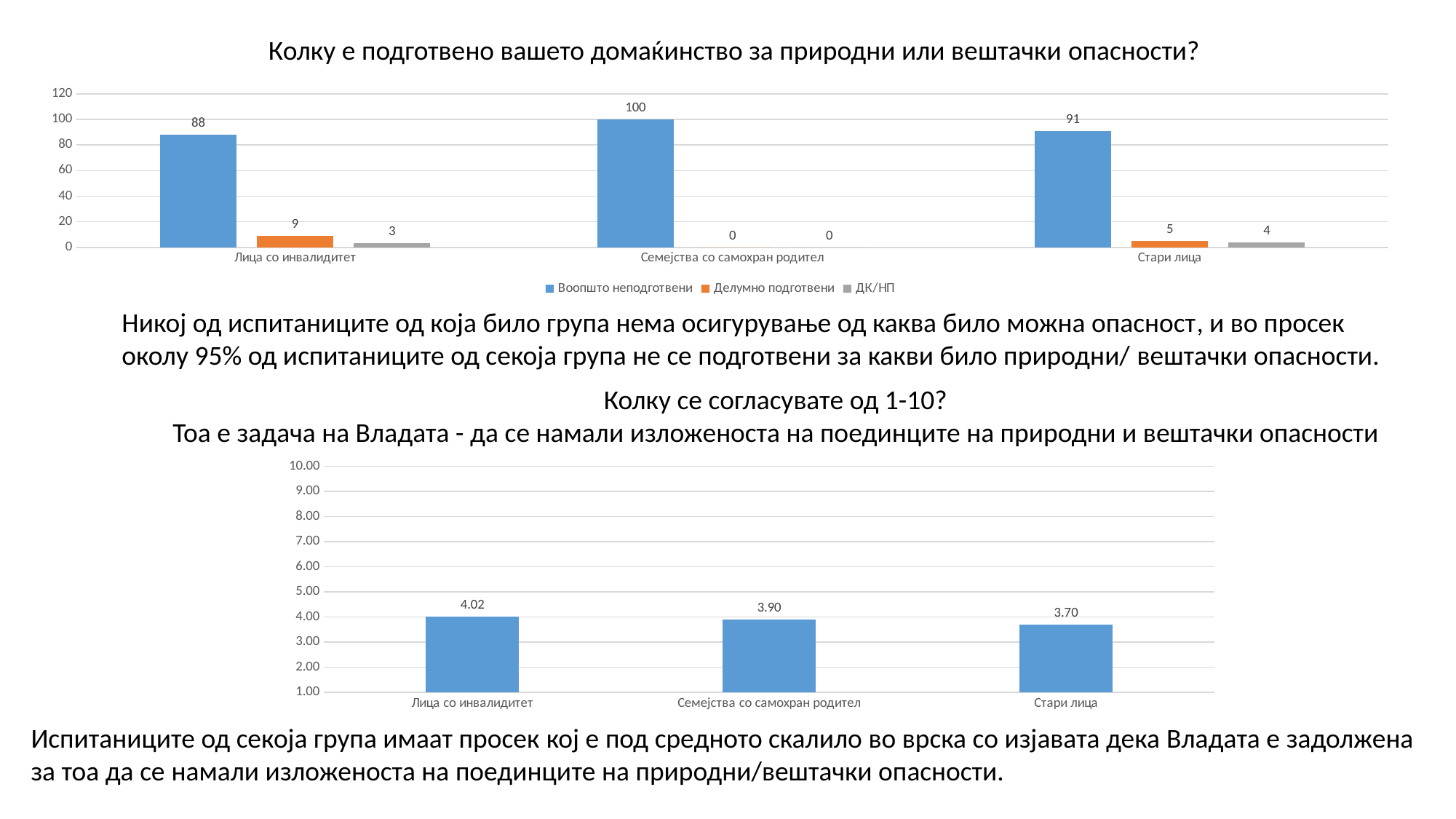
In the top chart, how many categories are shown on the x axis? 3 In the top chart, which category has the highest value for 'Воопшто неподготвени'? Семејства со самохран родител In the bottom chart, what is the value for 'Стари лица'? 3.70 In the top chart, what is the value for 'Воопшто неподготвени' for 'Лица со инвалидитет'? 88 In the top chart, how many series does the legend list? 3 In the top chart, what is the value for 'ДК/НП' for 'Лица со инвалидитет'? 3 In the top chart, what is the value for 'Делумно подготвени' for 'Стари лица'? 5 In the bottom chart, what is the difference between the values for 'Лица со инвалидитет' and 'Семејства со самохран родител'? 0.12 In the top chart, what is the difference between the 'Воопшто неподготвени' values for 'Семејства со самохран родител' and 'Лица со инвалидитет'? 12 What kind of chart is the bottom chart? Bar chart In the bottom chart, which category has the lowest value? Стари лица In the bottom chart, which category has the highest value? Лица со инвалидитет